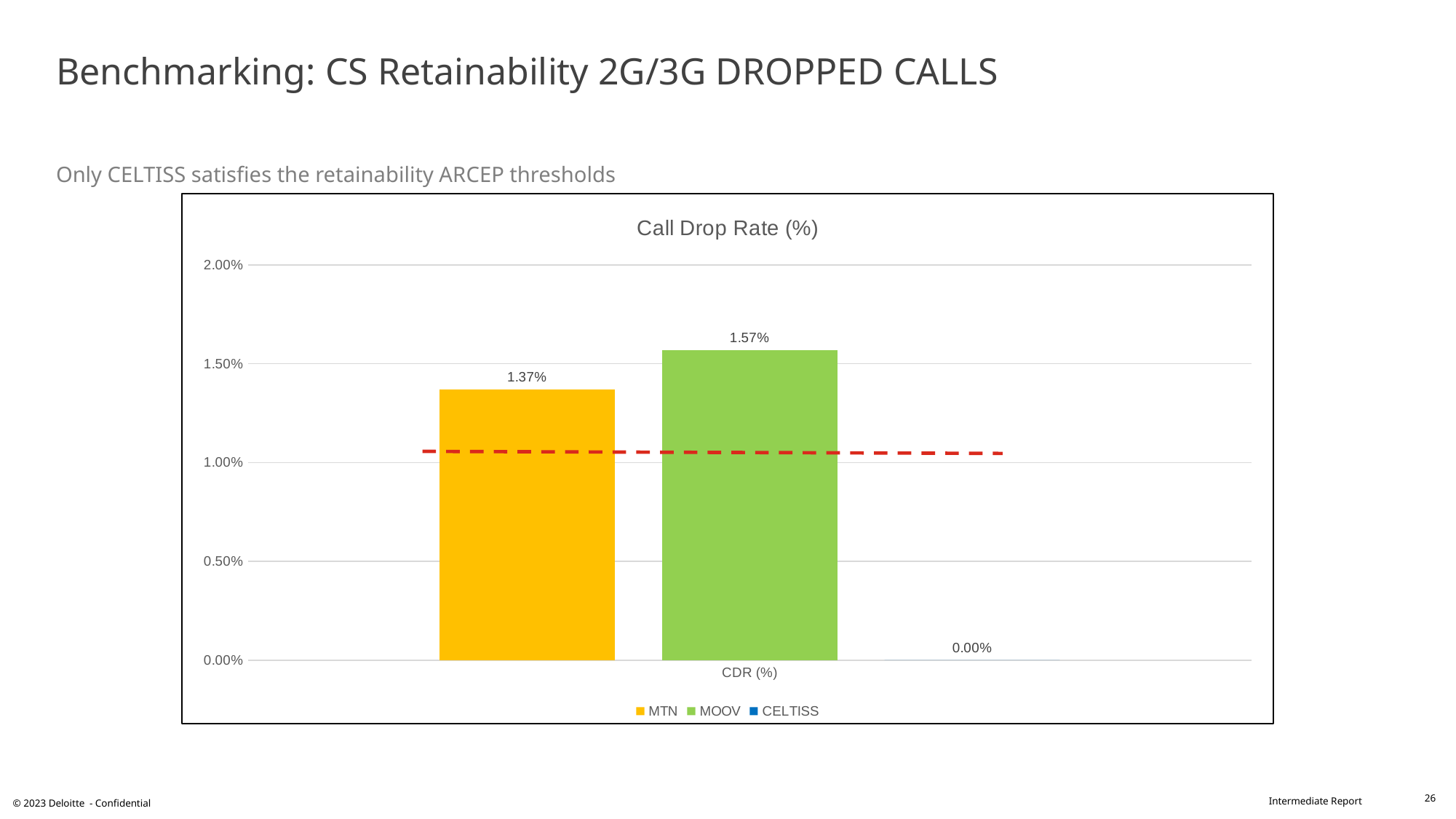
Which operator has the lowest Call Drop Rate? CELTISS What is the title of the chart? Call Drop Rate (%) What is the difference between the Call Drop Rate of MOOV and MTN? 0.20% What colour is the bar for MOOV? Green What kind of chart is shown on the slide? Bar chart Which has a higher Call Drop Rate, MTN or MOOV? MOOV Which operator has the highest Call Drop Rate? MOOV What is the Call Drop Rate for MOOV? 1.57% How many series does the legend list? 3 Is the Call Drop Rate for MTN greater or less than 1.00%? greater What is the Call Drop Rate for CELTISS? 0.00% What is the Call Drop Rate for MTN? 1.37%